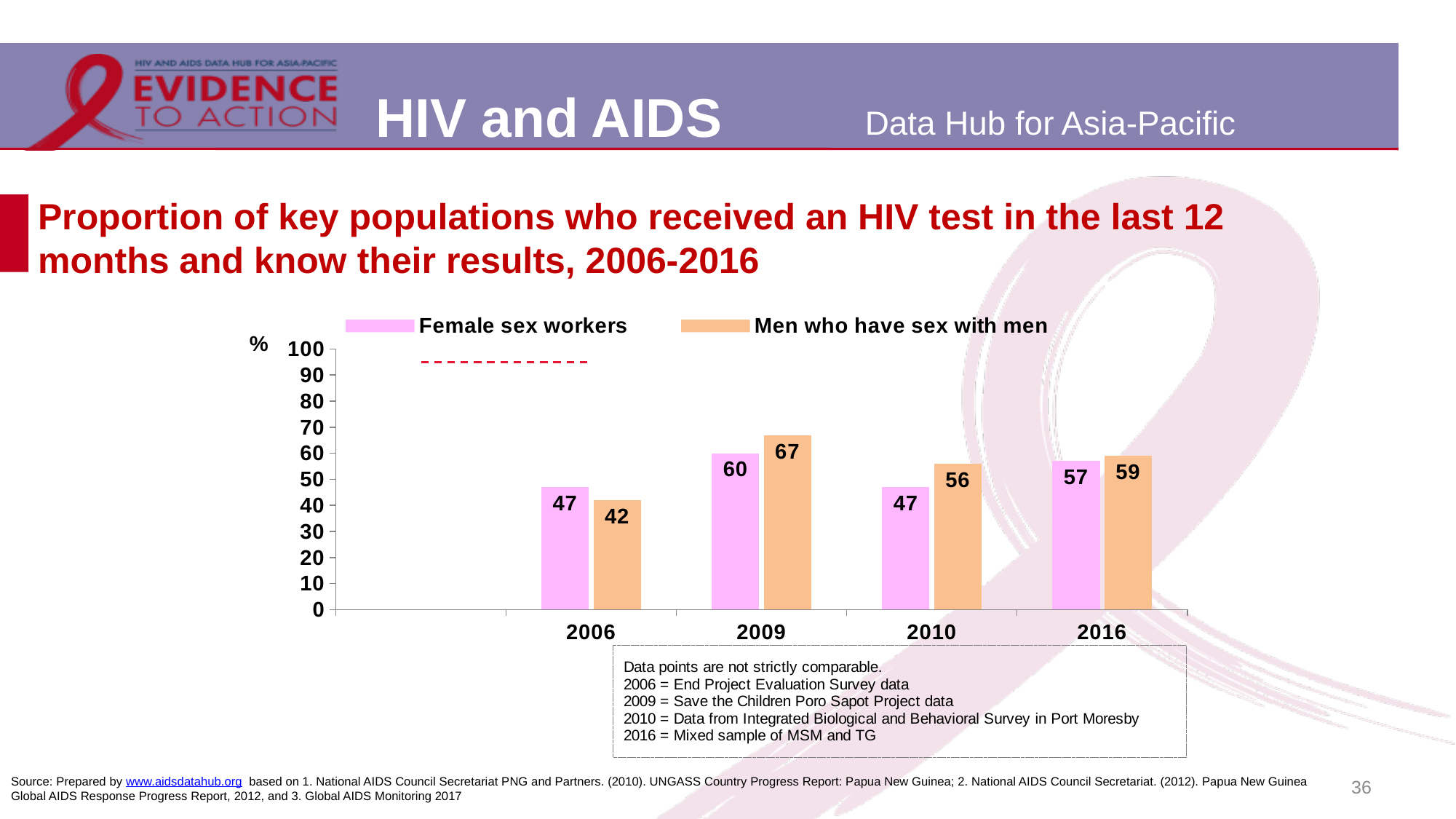
What unit is shown on the y axis? % What is the difference between the Men who have sex with men and Female sex workers values in 2010? 9 What kind of chart is shown on the slide? bar chart In which year is the value for Men who have sex with men lowest? 2006 In which year is the value for Female sex workers highest? 2009 How many years are shown on the x axis? 4 How many series does the legend list? 2 Is the value for Men who have sex with men in 2009 greater or less than 60? greater In 2006, which series has the larger value: Female sex workers or Men who have sex with men? Female sex workers What is the value for Men who have sex with men in 2016? 59 What is the value for Female sex workers in 2006? 47 What is the value for Men who have sex with men in 2009? 67